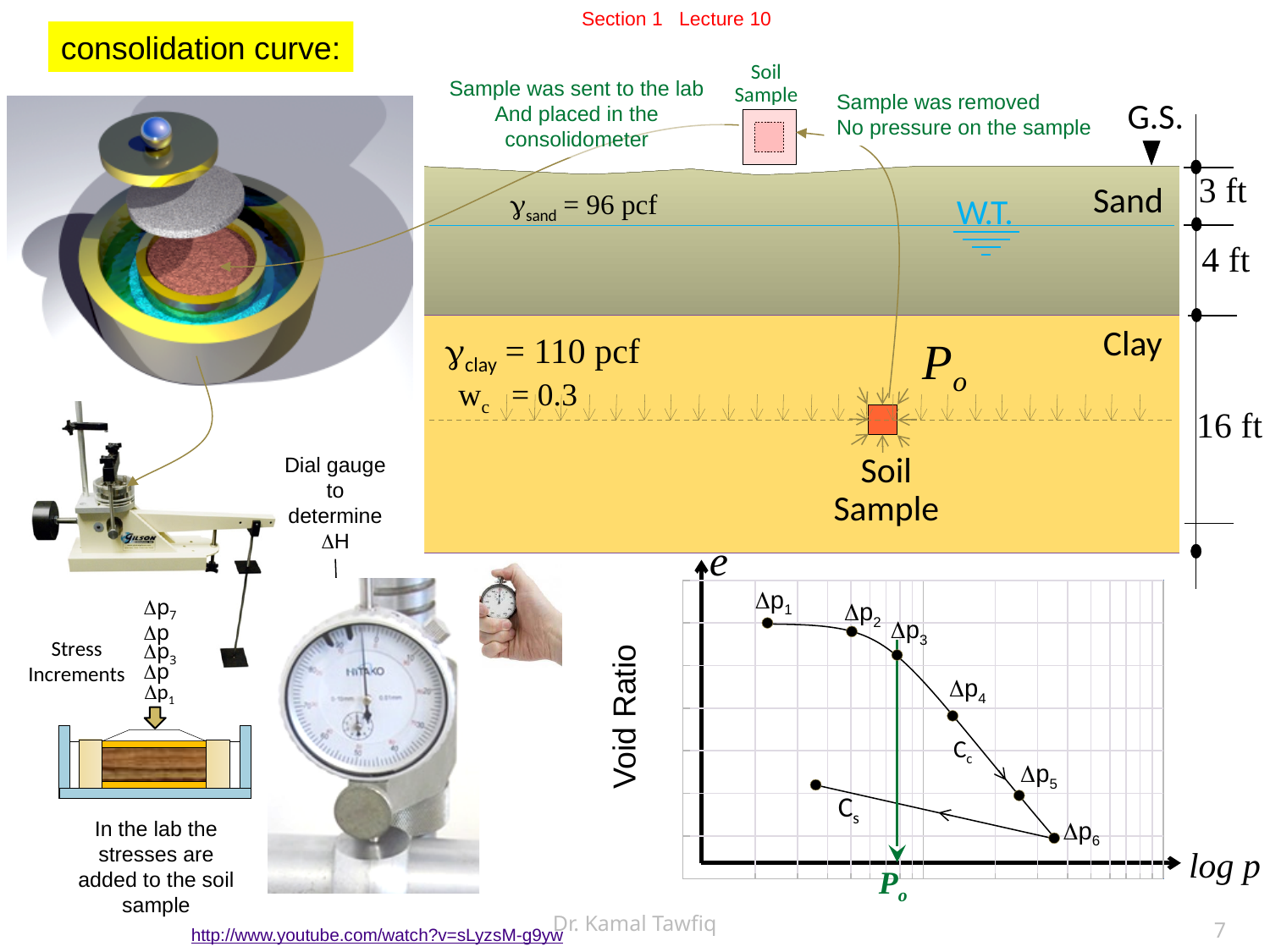
Which labeled stress increment point on the consolidation curve has the lowest void ratio? Δp6 Which labeled stress increment point on the consolidation curve has the highest void ratio? Δp1 On the consolidation curve, which point has the higher void ratio, Δp4 or Δp6? Δp4 On the consolidation curve, which point has the higher void ratio, Δp2 or Δp5? Δp2 How many stress increment points labeled Δp are marked on the consolidation curve? 6 On the consolidation curve chart, what quantity is plotted on the vertical axis? Void Ratio (e) What kind of chart is the consolidation curve plot at the bottom right of the slide? line chart Along the loading curve from Δp1 to Δp6, does the void ratio rise or fall as log p increases? fall On the consolidation curve chart, what is the label on the horizontal axis? log p On the consolidation curve, which point lies further to the right along the log p axis, Δp3 or Δp5? Δp5